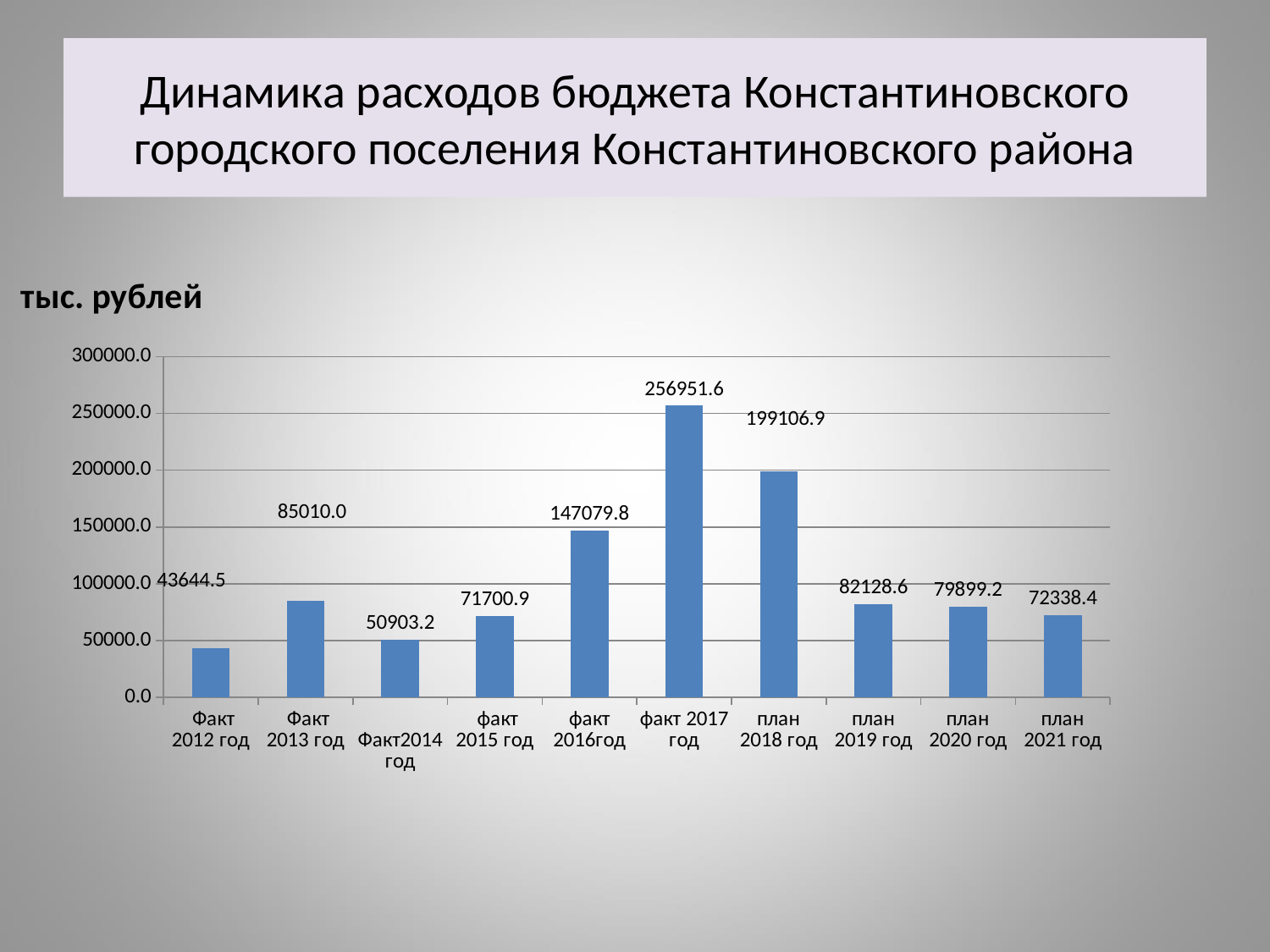
Which category has the lowest value? Факт 2012 год How many categories are shown on the x axis? 10 Which is larger, the value for факт 2016год or the value for план 2019 год? факт 2016год What is the difference between the values for Факт 2013 год and Факт 2012 год? 41365.5 What is the difference between the values for факт 2017 год and план 2018 год? 57844.7 What kind of chart is shown on the slide? bar chart Is the value for план 2018 год greater or less than 150000.0? greater What unit is stated above the chart? тыс. рублей What is the value for факт 2017 год? 256951.6 What is the value for Факт 2012 год? 43644.5 Which category has the highest value? факт 2017 год What is the value for план 2021 год? 72338.4